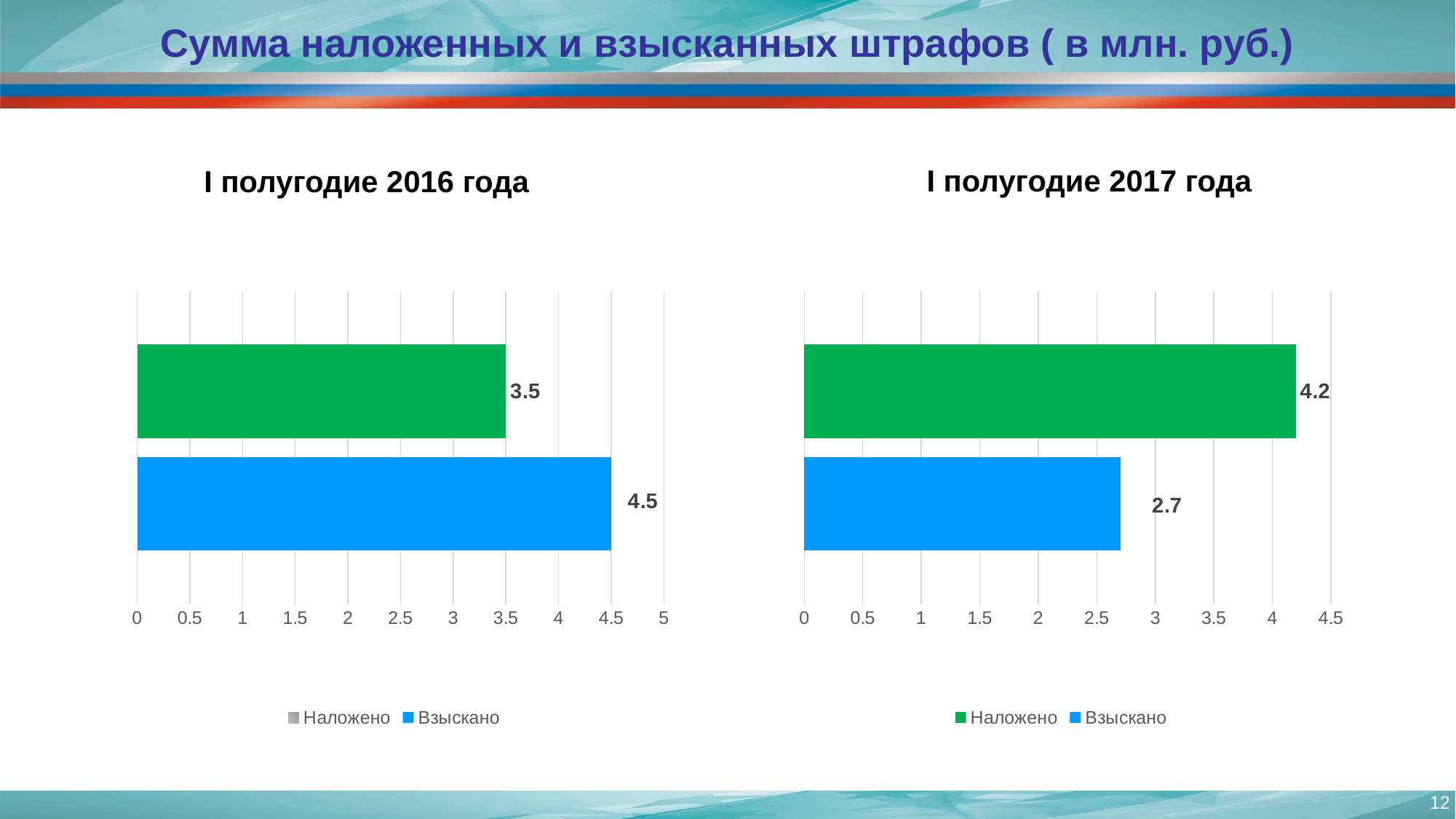
In the chart titled "I полугодие 2016 года", what is the difference between Взыскано and Наложено? 1 How many series does the legend of the chart titled "I полугодие 2017 года" list? 2 In the chart titled "I полугодие 2016 года", what is the value for Взыскано? 4.5 In the chart titled "I полугодие 2016 года", which series has the higher value, Наложено or Взыскано? Взыскано In the chart titled "I полугодие 2017 года", what is the value for Наложено? 4.2 In the chart titled "I полугодие 2017 года", what is the difference between Наложено and Взыскано? 1.5 In the chart titled "I полугодие 2017 года", is the value for Взыскано greater or less than 3? less In the chart titled "I полугодие 2017 года", what is the value for Взыскано? 2.7 In the chart titled "I полугодие 2017 года", which series has the lower value? Взыскано In the chart titled "I полугодие 2016 года", what is the value for Наложено? 3.5 In the chart titled "I полугодие 2017 года", what colour is the Наложено bar? green What kind of chart is the chart titled "I полугодие 2016 года"? bar chart